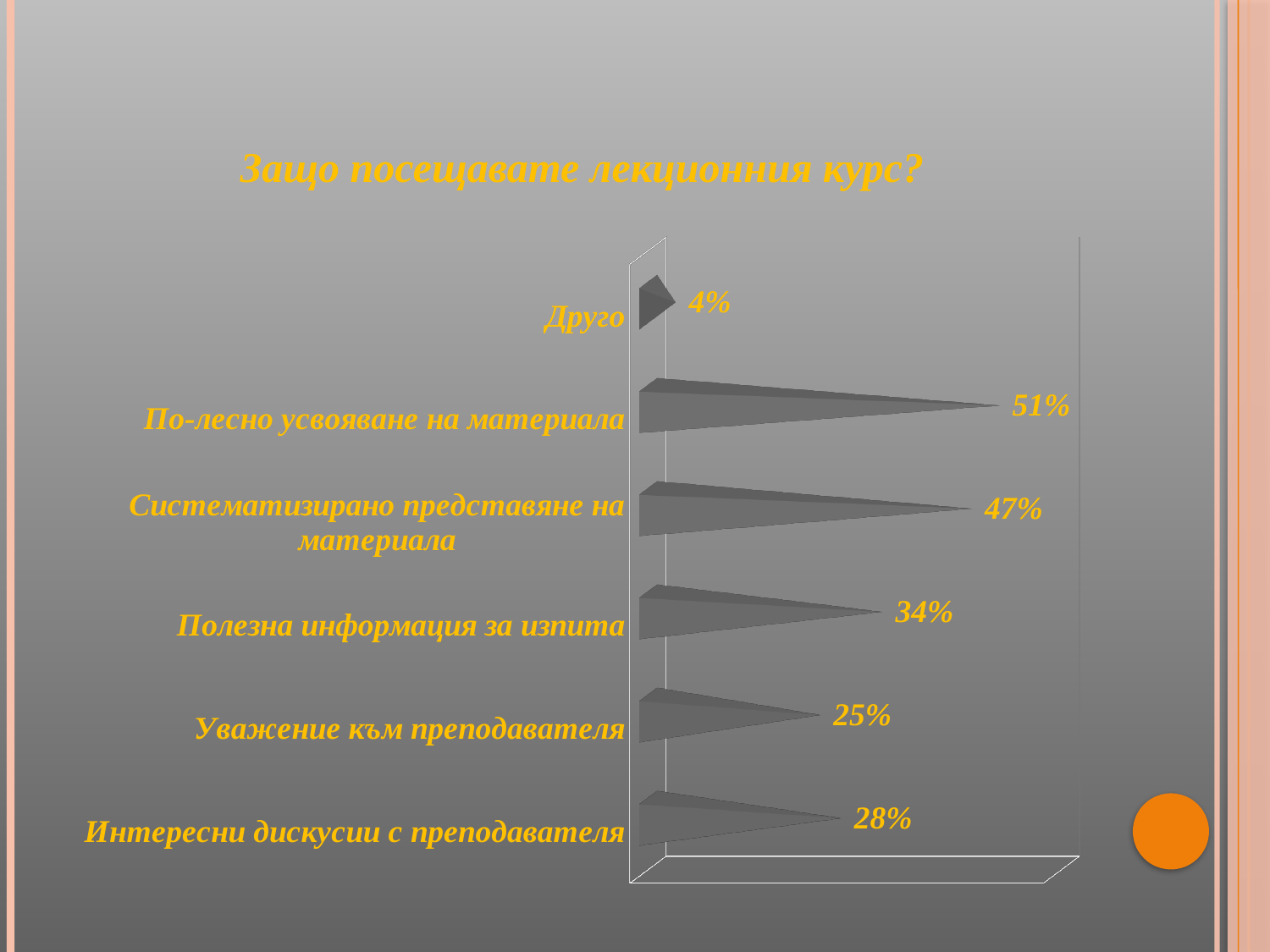
What kind of chart is shown on the slide? Bar chart Which category has the highest value? По-лесно усвояване на материала What is the title of the chart? Защо посещавате лекционния курс? What is the value for "По-лесно усвояване на материала"? 51% What is the difference between "Интересни дискусии с преподавателя" and "Уважение към преподавателя"? 3% What is the value for "Друго"? 4% What is the difference between "По-лесно усвояване на материала" and "Систематизирано представяне на материала"? 4% Which is larger: "Полезна информация за изпита" or "Уважение към преподавателя"? Полезна информация за изпита Which category has the lowest value? Друго How many categories are shown in the chart? 6 What is the value for "Уважение към преподавателя"? 25% What is the value for "Интересни дискусии с преподавателя"? 28%